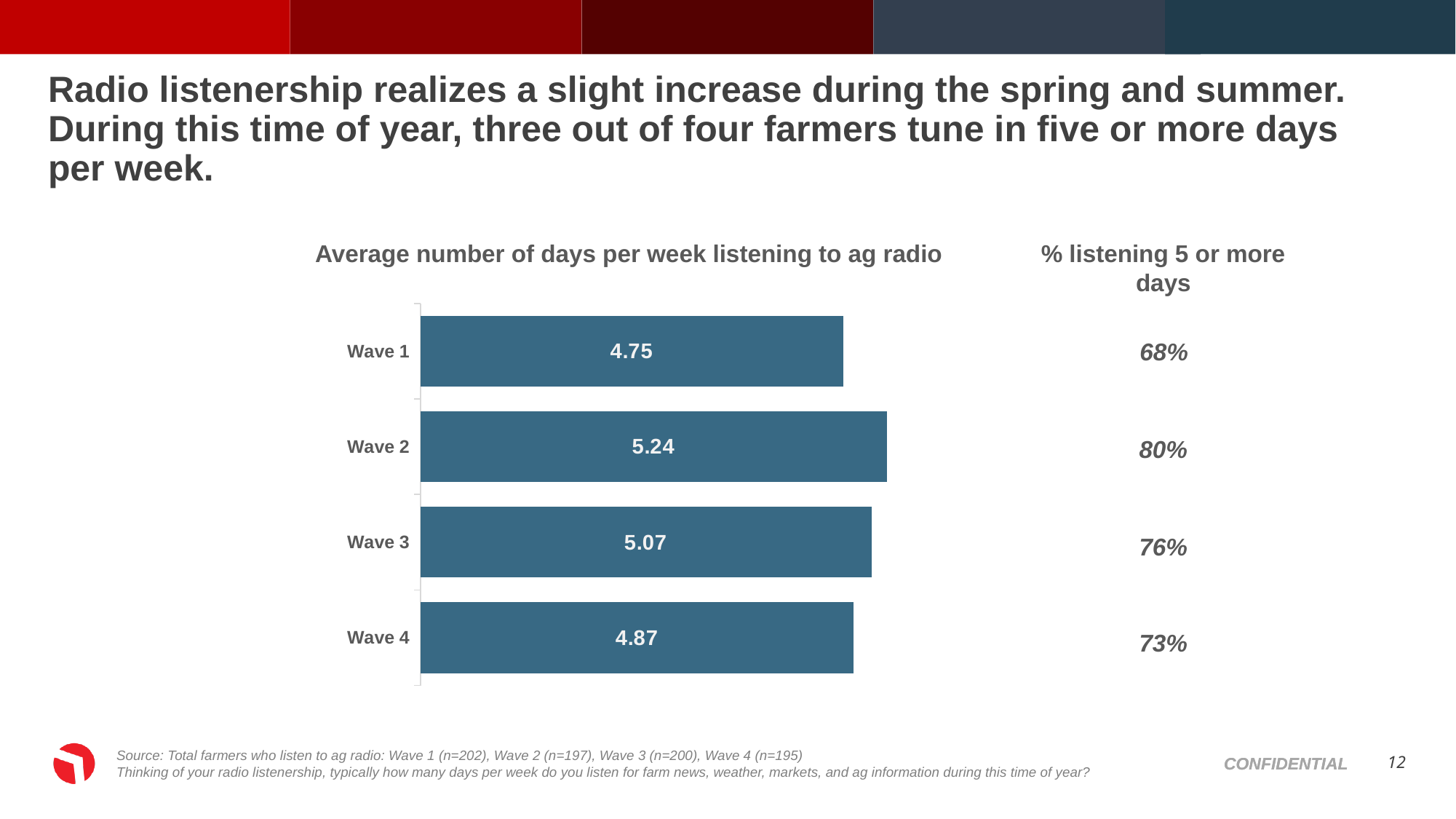
What is the average number of days per week listening to ag radio for Wave 4? 4.87 How many waves are shown in the chart? 4 What is the difference between the average days per week for Wave 3 and Wave 4? 0.20 Which has a higher average number of days per week listening to ag radio, Wave 3 or Wave 4? Wave 3 Which wave has the highest average number of days per week listening to ag radio? Wave 2 What is the title of the chart? Average number of days per week listening to ag radio Which wave has the lowest average number of days per week listening to ag radio? Wave 1 What is the average number of days per week listening to ag radio for Wave 2? 5.24 What is the difference between the average days per week for Wave 2 and Wave 1? 0.49 What kind of chart is used to show the average number of days per week listening to ag radio? Bar chart What percentage of farmers listened 5 or more days in Wave 2? 80% What is the average number of days per week listening to ag radio for Wave 1? 4.75